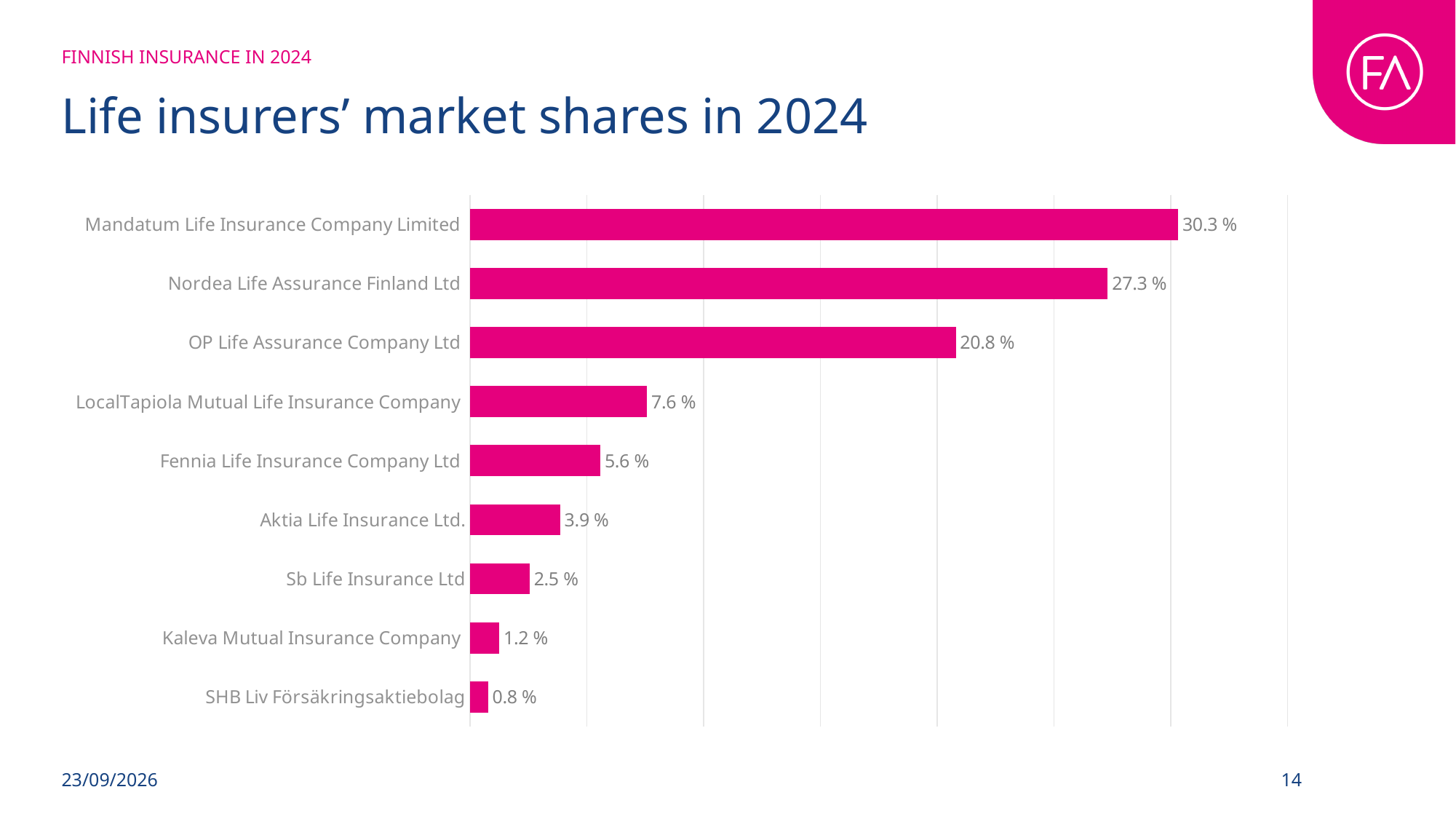
What is the market share of Mandatum Life Insurance Company Limited? 30.3 % Which insurer has the largest market share? Mandatum Life Insurance Company Limited What is the title of the chart on the slide? Life insurers’ market shares in 2024 What is the difference in market share between Mandatum Life Insurance Company Limited and Nordea Life Assurance Finland Ltd? 3.0 % What is the market share of Fennia Life Insurance Company Ltd? 5.6 % What kind of chart is shown on the slide? Bar chart What is the difference in market share between LocalTapiola Mutual Life Insurance Company and Aktia Life Insurance Ltd.? 3.7 % How many insurers are shown in the chart? 9 What is the market share of Kaleva Mutual Insurance Company? 1.2 % What is the market share of OP Life Assurance Company Ltd? 20.8 % Which has a larger market share, Sb Life Insurance Ltd or Aktia Life Insurance Ltd.? Aktia Life Insurance Ltd. Which insurer has the smallest market share? SHB Liv Försäkringsaktiebolag